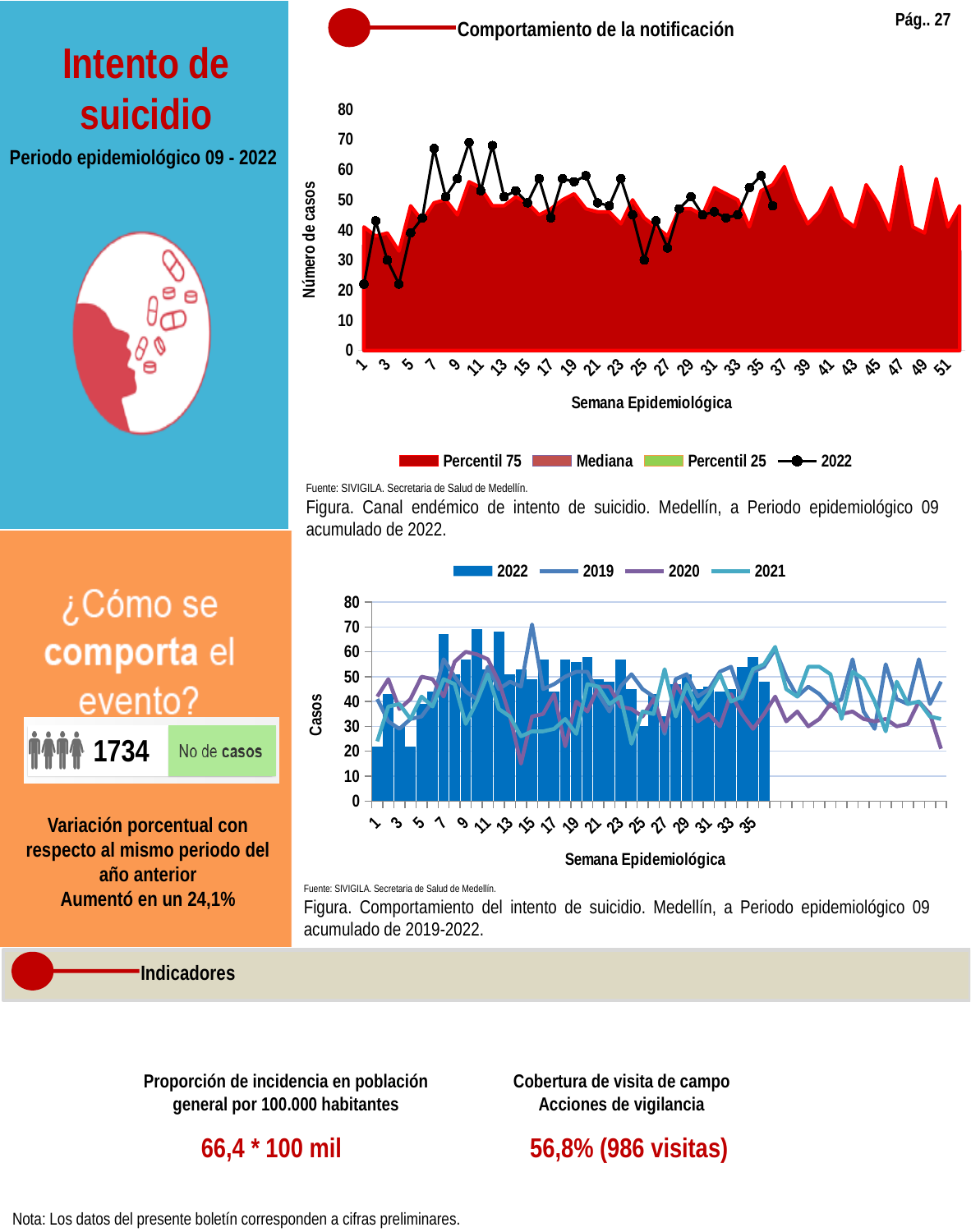
In the top chart (Canal endémico), what is the label of the y axis? Número de casos In the top chart (Canal endémico), is the 2022 value for week 10 greater or less than 60? greater In the top chart (Canal endémico), is the 2022 value for week 7 greater or less than 60? greater In the top chart (Canal endémico), how many series does the legend list? 4 In the bottom chart (Comportamiento del intento de suicidio), which series is drawn as bars? 2022 In the bottom chart (Comportamiento del intento de suicidio), is the 2022 bar for week 4 greater or less than 30? less In the bottom chart (Comportamiento del intento de suicidio), how many series does the legend list? 4 In the top chart (Canal endémico), what are the legend entries? Percentil 75, Mediana, Percentil 25, 2022 What kind of chart is the bottom chart (Comportamiento del intento de suicidio)? Bar chart combined with line series In the bottom chart (Comportamiento del intento de suicidio), how many weeks have a 2022 bar plotted? 36